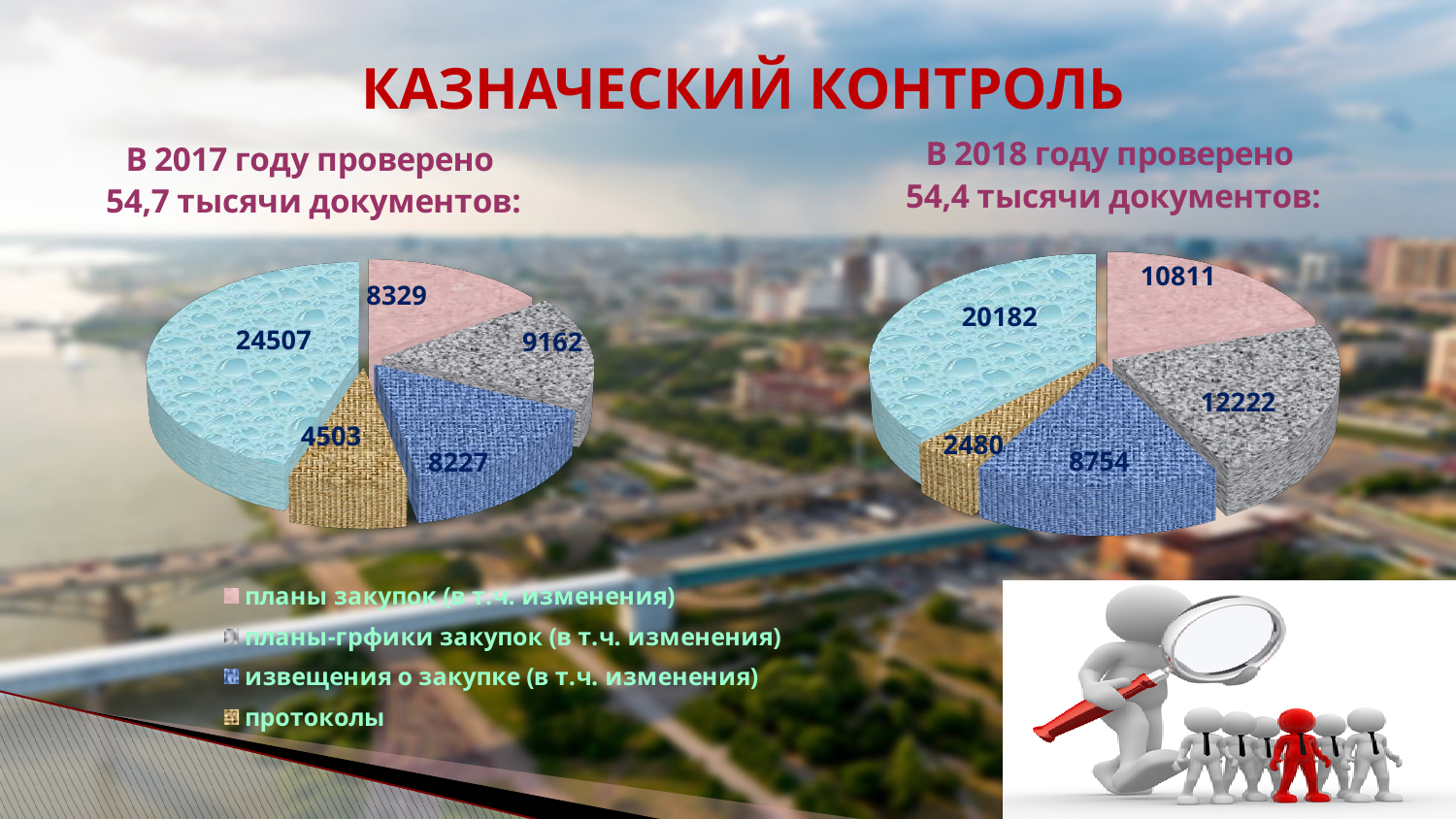
In the 2018 chart, which is larger: планы закупок or планы-грфики закупок? планы-грфики закупок How many entries does the legend list? 4 In the 2017 chart, what is the value for протоколы? 4503 By how much did the value for протоколы decrease from the 2017 chart to the 2018 chart? 2023 How many slices does the 2017 pie chart have? 5 In the 2017 chart, what is the value for планы закупок (в т.ч. изменения)? 8329 In the 2018 chart, what is the value for планы-грфики закупок (в т.ч. изменения)? 12222 In the 2018 chart, which legend category has the smallest slice? протоколы In the 2018 chart, what is the value for извещения о закупке (в т.ч. изменения)? 8754 In the 2017 chart, what is the difference between планы-грфики закупок and планы закупок? 833 In the 2017 chart, what is the value of the largest slice? 24507 What kind of chart is used to show the 2017 data? pie chart